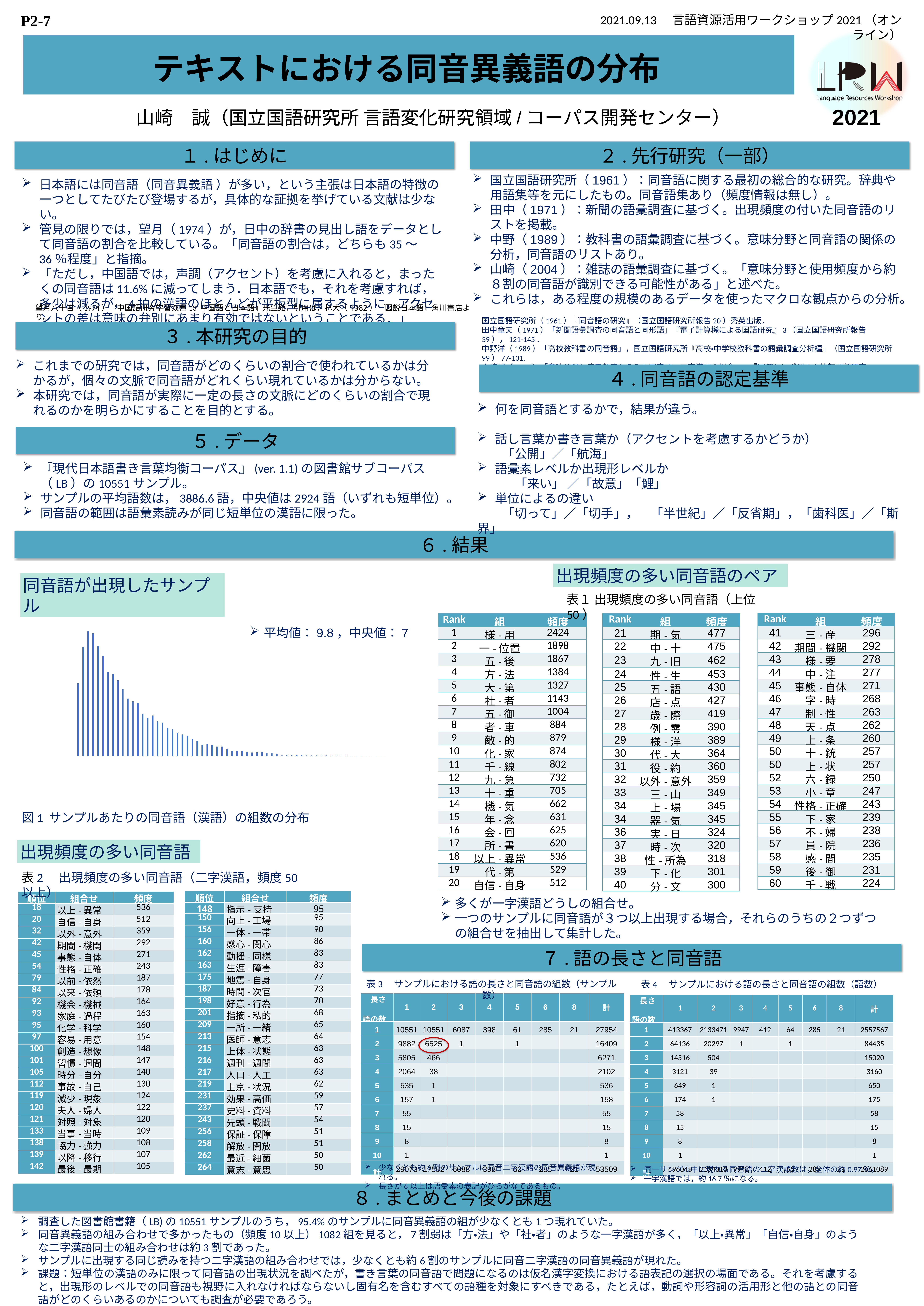
In 図1, after the tallest bar near the left, do the bar heights rise or fall moving to the right along the x axis? fall What mean value (平均値) is stated next to the bar chart in 図1? 9.8 What kind of chart is 図1 (サンプルあたりの同音語（漢語）の組数の分布)? bar chart What is the caption (title) of the bar chart in section 6? 図1 サンプルあたりの同音語（漢語）の組数の分布